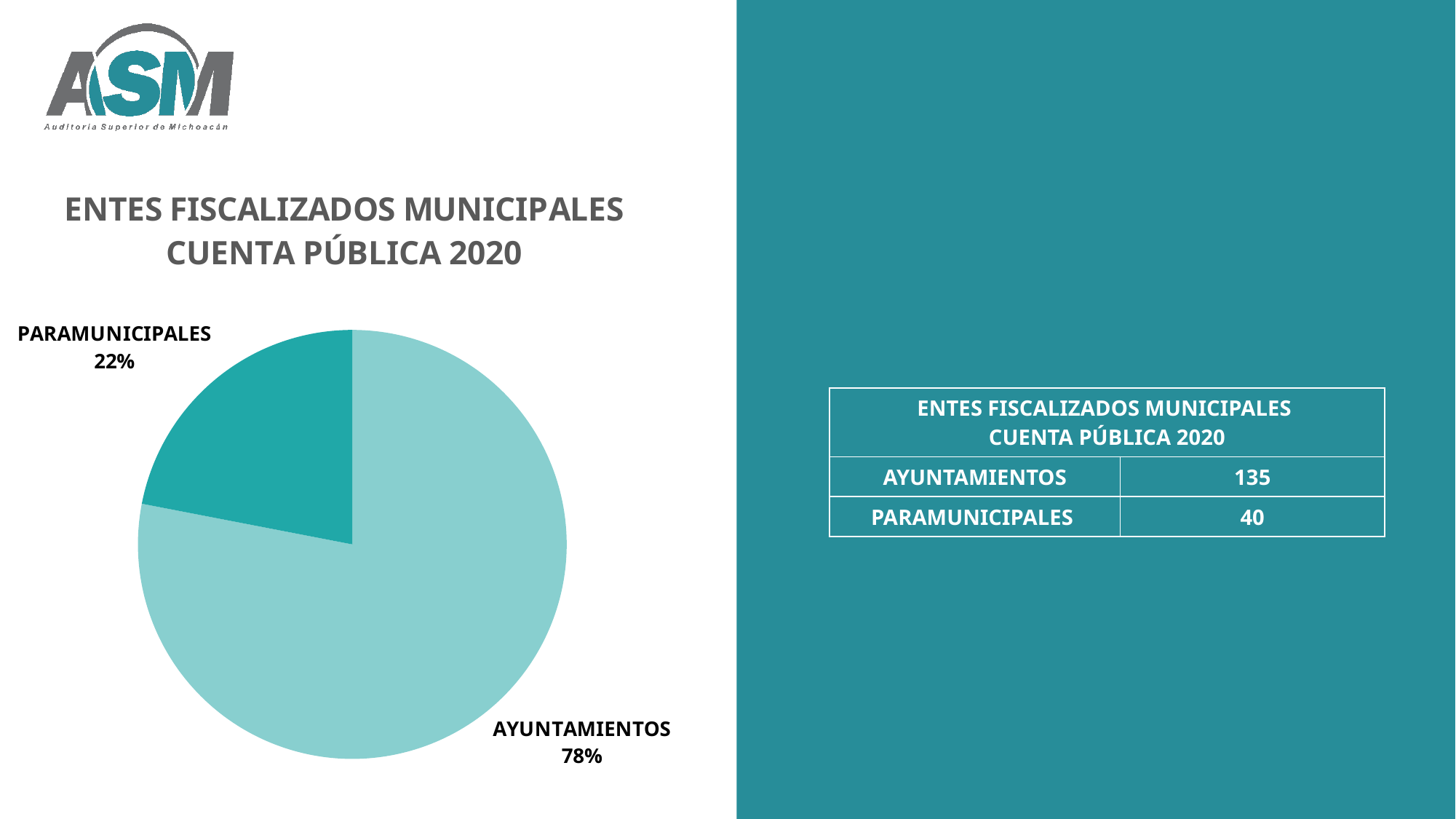
Which slice of the pie chart is drawn in the darker teal colour? PARAMUNICIPALES What kind of chart is shown on the slide? Pie chart What is the difference in percentage points between the AYUNTAMIENTOS slice and the PARAMUNICIPALES slice? 56 Which slice of the pie chart is the largest? AYUNTAMIENTOS How many slices does the pie chart have? 2 According to the table on the slide, how many PARAMUNICIPALES are there? 40 Which is larger, the AYUNTAMIENTOS slice or the PARAMUNICIPALES slice? AYUNTAMIENTOS According to the table on the slide, how many AYUNTAMIENTOS are there? 135 What is the title of the chart on the slide? ENTES FISCALIZADOS MUNICIPALES CUENTA PÚBLICA 2020 What share of the pie does AYUNTAMIENTOS represent? 78% Which slice of the pie chart is the smallest? PARAMUNICIPALES What share of the pie does PARAMUNICIPALES represent? 22%